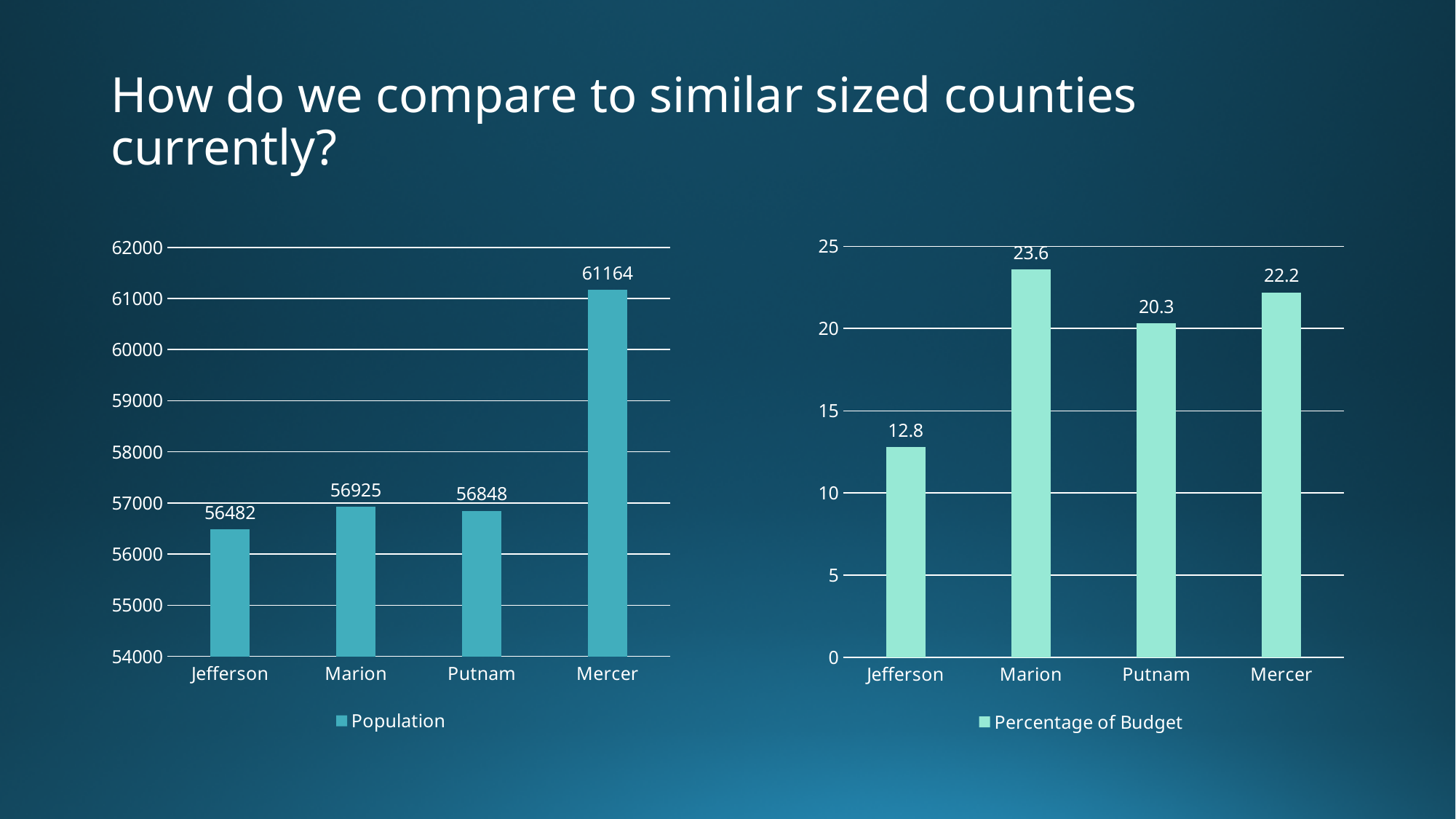
In the right chart (Percentage of Budget), what is the difference between Marion and Jefferson? 10.8 In the left chart (Population), what is the difference in population between Marion and Putnam? 77 What is the legend entry of the right chart? Percentage of Budget In the left chart (Population), how many counties are shown? 4 In the right chart (Percentage of Budget), is the value for Jefferson greater or less than 15? less What kind of chart is the right chart (Percentage of Budget)? bar chart In the left chart (Population), what is the population of Mercer? 61164 In the left chart (Population), which county has the lowest population? Jefferson How many series does the legend of the left chart list? 1 In the left chart (Population), which is larger, the population of Jefferson or Putnam? Putnam In the right chart (Percentage of Budget), which county has the highest value? Marion In the right chart (Percentage of Budget), what is the value for Putnam? 20.3